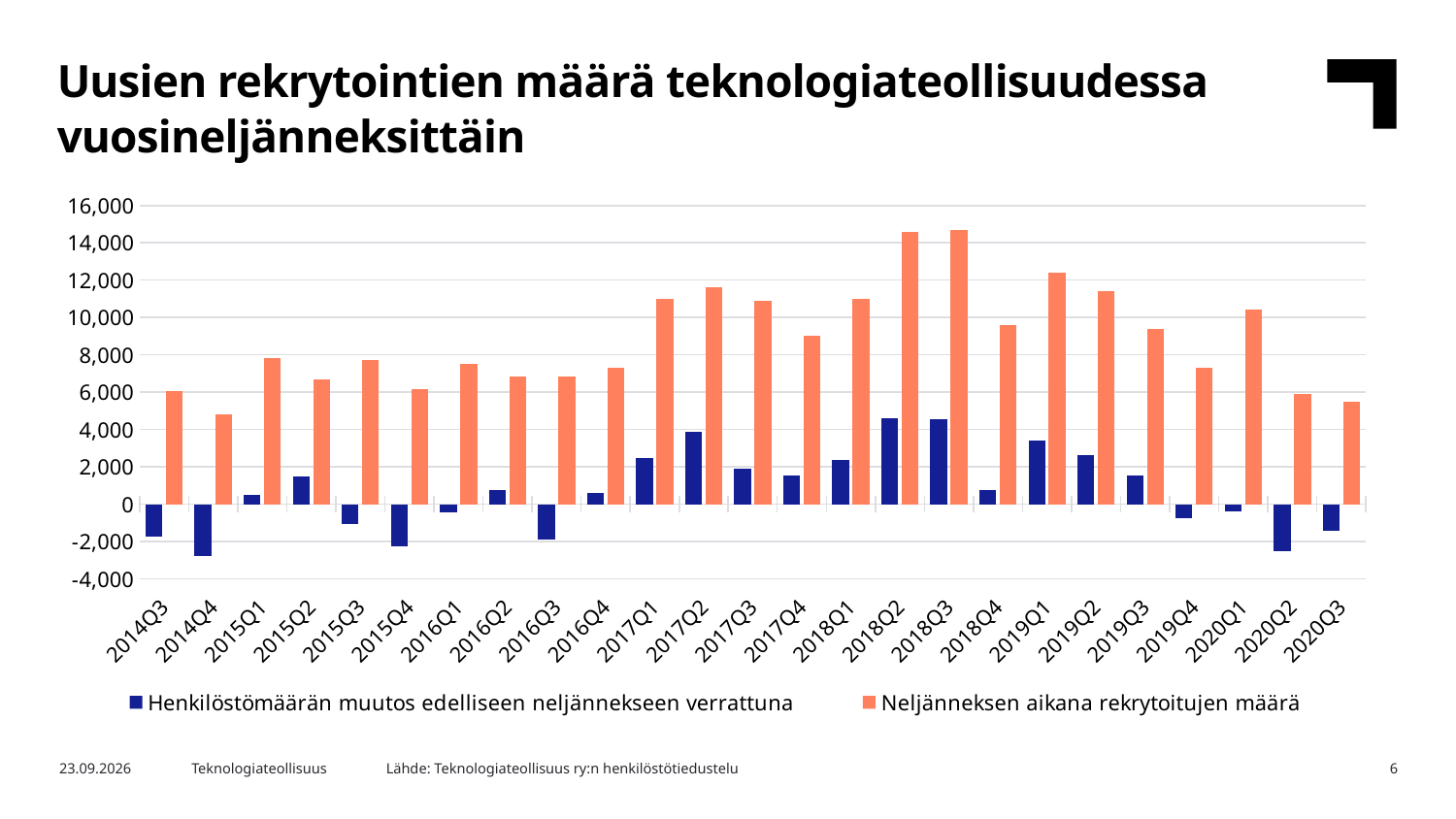
Is the value for 'Neljänneksen aikana rekrytoitujen määrä' in 2014Q4 greater or less than 6,000? less What kind of chart is shown on the slide? Bar chart Is the value for 'Henkilöstömäärän muutos edelliseen neljännekseen verrattuna' in 2014Q4 greater or less than -2,000? less Is the value for 'Henkilöstömäärän muutos edelliseen neljännekseen verrattuna' in 2017Q2 greater or less than 2,000? greater Which quarter has the lowest value for 'Neljänneksen aikana rekrytoitujen määrä'? 2014Q4 Does the value for 'Neljänneksen aikana rekrytoitujen määrä' rise or fall from 2019Q1 to 2019Q4? fall Which is larger for 'Neljänneksen aikana rekrytoitujen määrä': 2019Q1 or 2019Q2? 2019Q1 How many quarters are shown on the x axis? 25 What colour are the bars for 'Neljänneksen aikana rekrytoitujen määrä'? Orange How many series does the legend list? 2